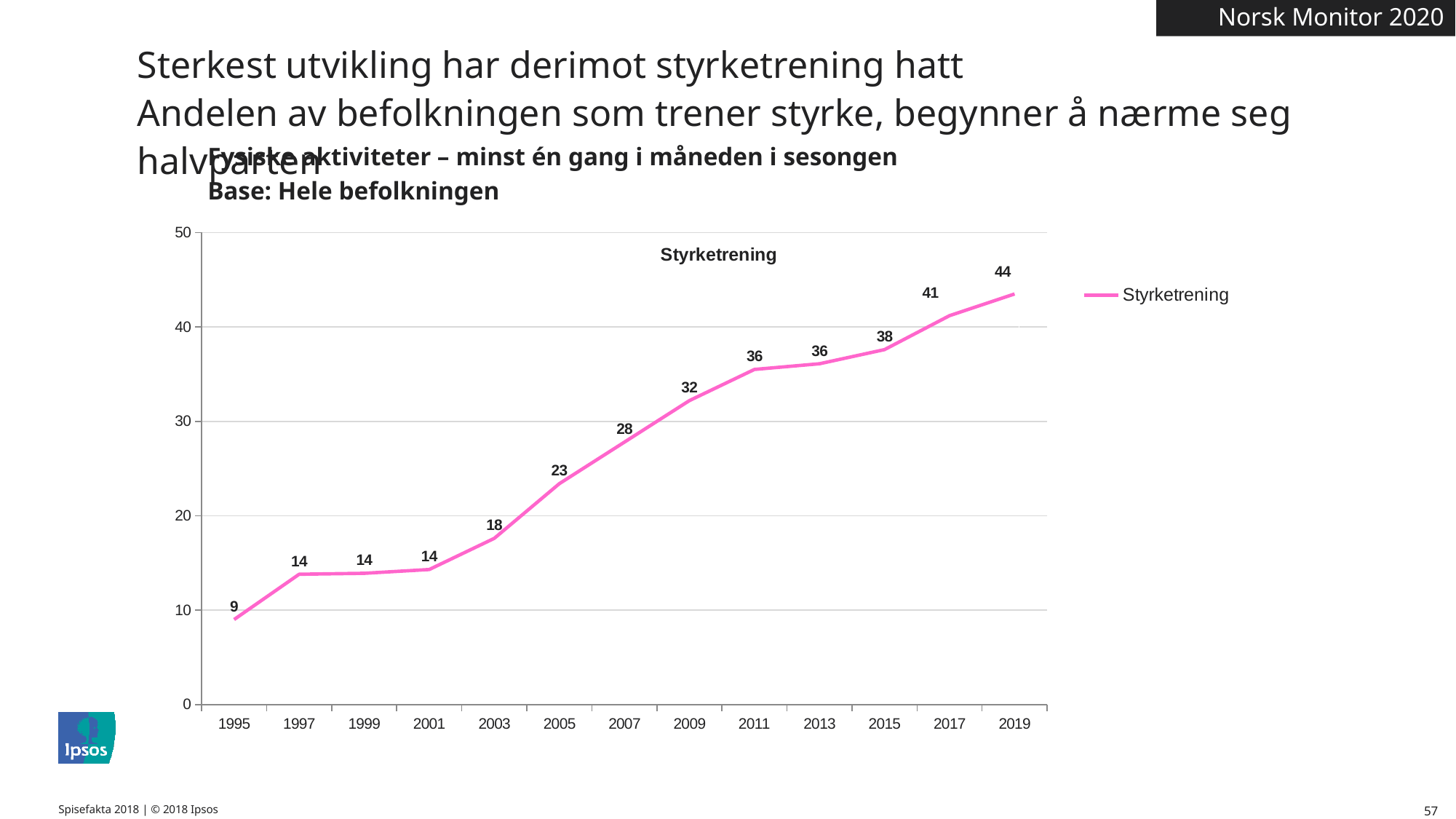
What is the value for Styrketrening in 2009? 32 Which is larger, the Styrketrening value for 2005 or for 2007? 2007 Which year has the lowest value for Styrketrening? 1995 What is the value for Styrketrening in 1995? 9 Which year has the highest value for Styrketrening? 2019 How many years are plotted on the x axis? 13 What is the difference between the Styrketrening values for 2019 and 1995? 35 What is the value for Styrketrening in 2019? 44 Do the Styrketrening values rise or fall from 1995 to 2019? rise What kind of chart is shown on the slide? line chart Is the value for Styrketrening in 2015 greater or less than 40? less How many series does the legend list? 1